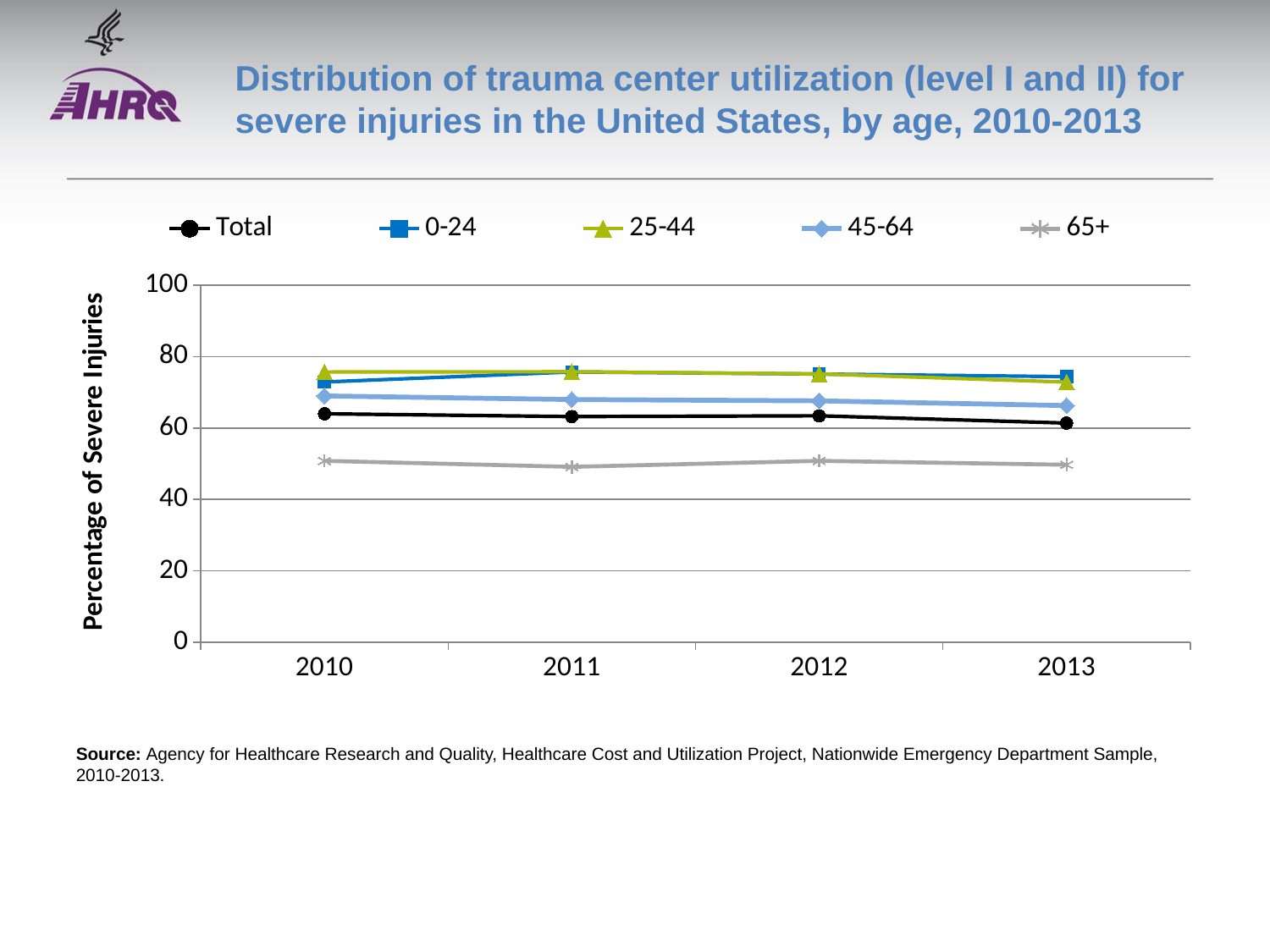
Is the value for the 65+ group in 2011 greater or less than 40? greater How many years are plotted along the x axis? 4 In 2013, which is larger: the value for Total or the value for 65+? Total Does the Total series rise or fall from 2010 to 2013? fall Which age group has the lowest percentage of severe injuries treated at trauma centers across all years? 65+ How many series does the legend list? 5 Is the value for the 25-44 group in 2010 greater or less than 60? greater Is the value for the 65+ group in 2010 greater or less than 60? less What kind of chart is shown on the slide? line chart In 2012, which is larger: the value for 45-64 or the value for 65+? 45-64 What is the label of the y axis? Percentage of Severe Injuries